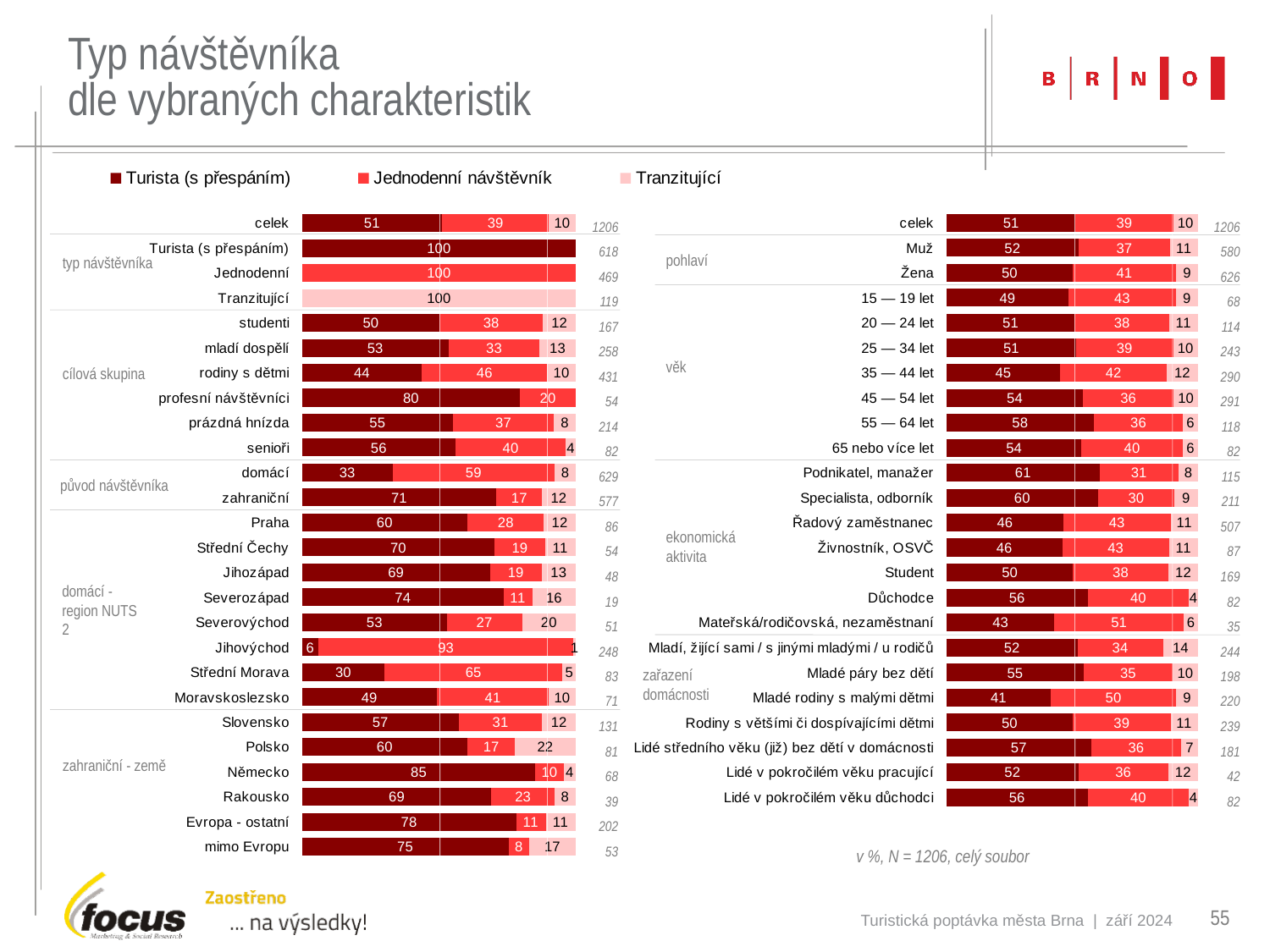
In the left chart, what is the value for Tranzitující in the Polsko category? 22 In the right chart, which has the larger Turista (s přespáním) value: 55 — 64 let or 35 — 44 let? 55 — 64 let In the left chart, which category has the lowest value for Turista (s přespáním)? Jihovýchod In the right chart, what is the value for Jednodenní návštěvník in the Mateřská/rodičovská, nezaměstnaní category? 51 In the right chart, which category has the highest value for Turista (s přespáním)? Podnikatel, manažer In the right chart, what is the difference between the Turista (s přespáním) values for Podnikatel, manažer and Řadový zaměstnanec? 15 How many series does the legend list? 3 What are the three series named in the legend? Turista (s přespáním), Jednodenní návštěvník, Tranzitující In the left chart, which category has the highest value for Jednodenní návštěvník? Jednodenní In the right chart, what is the value for Tranzitující in the category Mladí, žijící sami / s jinými mladými / u rodičů? 14 What kind of chart is shown on the slide? Stacked bar chart In the left chart, what is the value for Turista (s přespáním) in the Německo category? 85